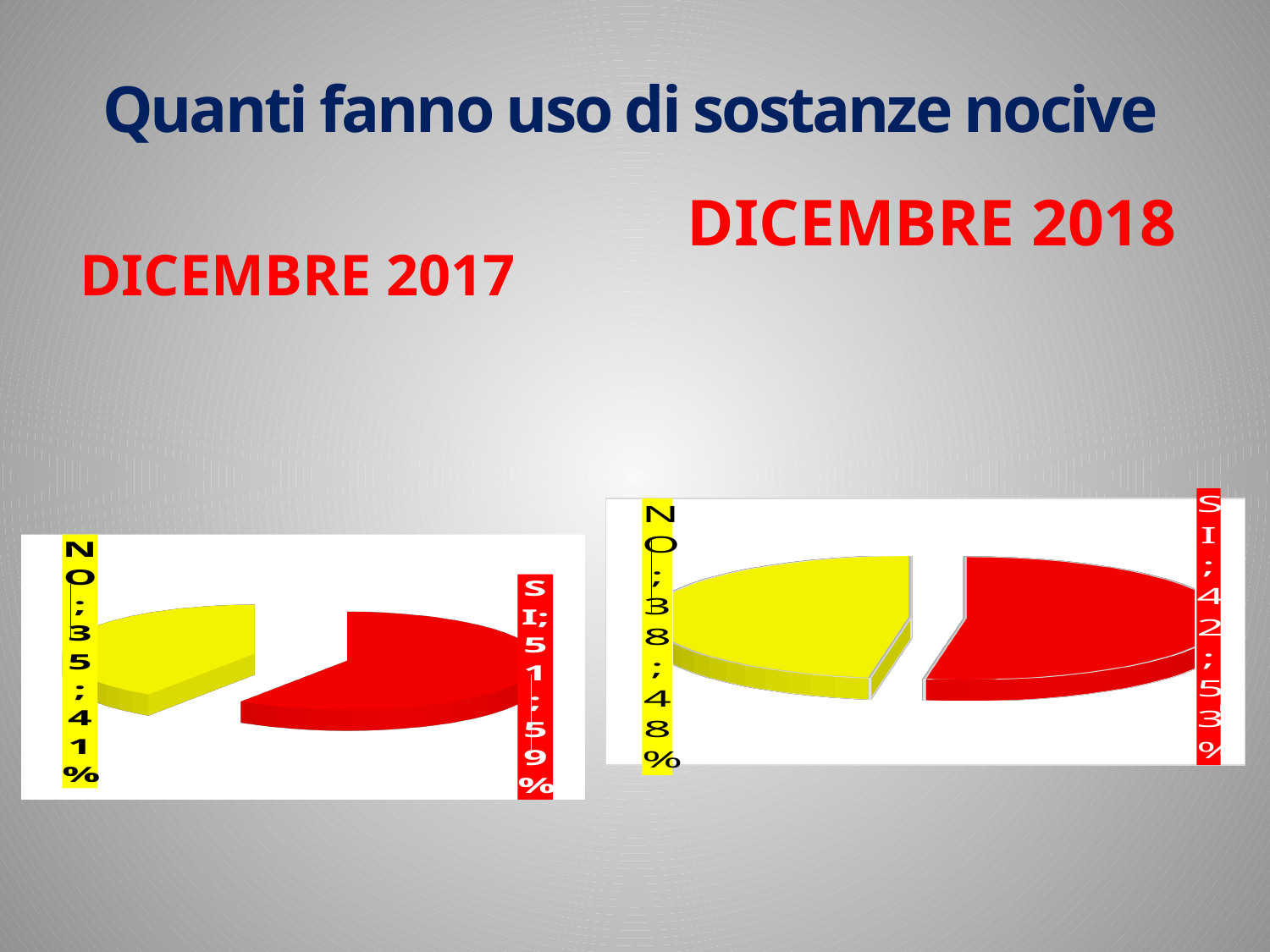
In the DICEMBRE 2017 chart, which category has the largest slice? SI In the DICEMBRE 2017 chart, what count is shown for NO? 35 In the DICEMBRE 2017 chart, what count is shown for SI? 51 In the DICEMBRE 2017 chart, what is the difference between the SI count and the NO count? 16 In the DICEMBRE 2018 chart, which slice is larger, SI or NO? SI In the DICEMBRE 2018 chart, what count is shown for NO? 38 In the DICEMBRE 2017 chart, what percentage is shown for SI? 59% How many slices does the DICEMBRE 2018 pie chart have? 2 In the DICEMBRE 2018 chart, what percentage is shown for SI? 53% In the DICEMBRE 2017 chart, what percentage is shown for NO? 41% What kind of chart is used for DICEMBRE 2017? pie chart In the DICEMBRE 2018 chart, what colour is the NO slice? yellow